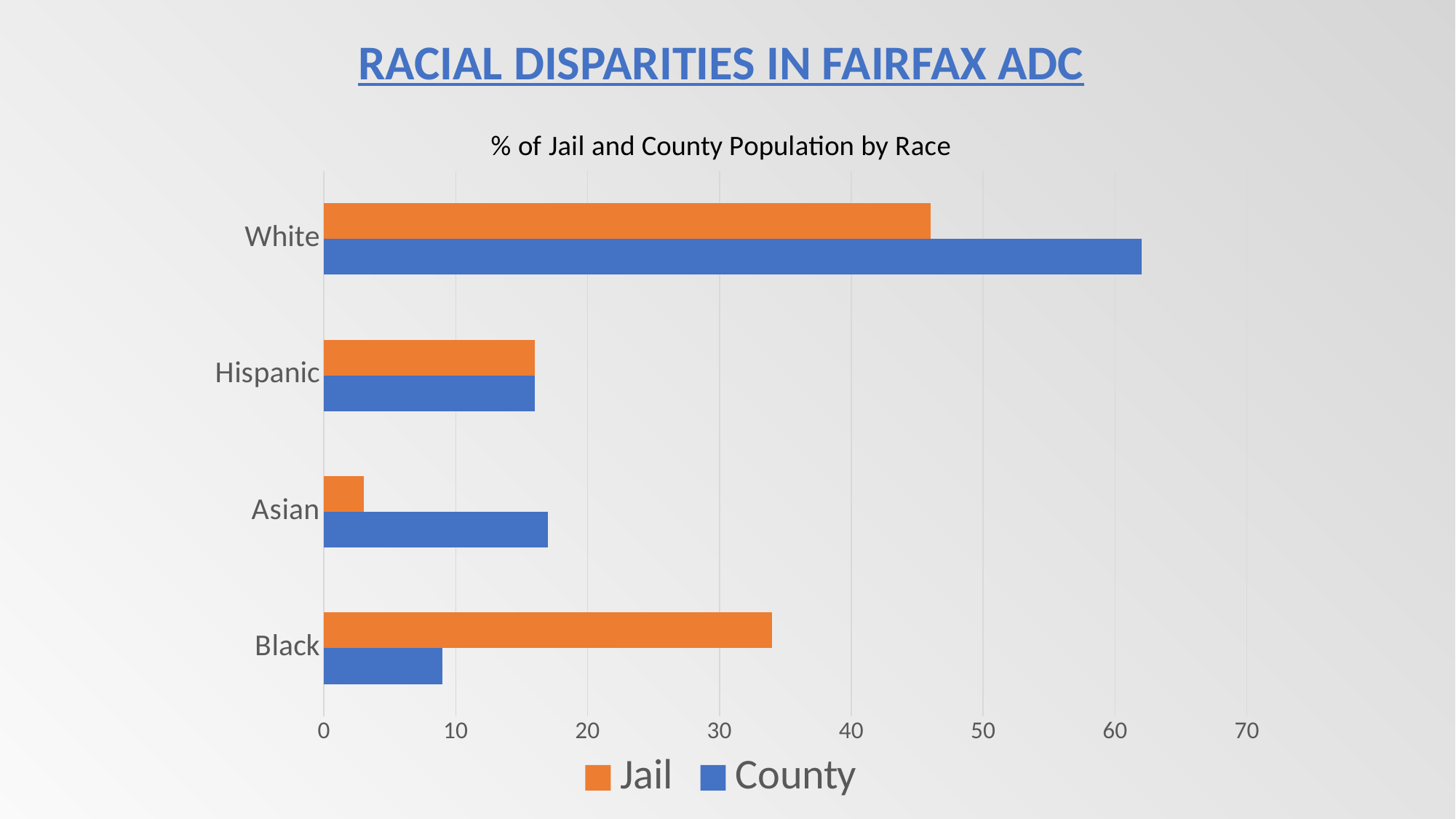
How many racial categories are plotted on the chart? 4 How many series does the legend list? 2 Which category has the lowest County value? Black Which category has the lowest Jail value? Asian Which category has the highest Jail value? White What kind of chart is shown on the slide? bar chart What is the subtitle of the chart? % of Jail and County Population by Race For Black, which is larger, the Jail value or the County value? Jail Is the Jail value for Black greater or less than 30? greater Is the County value for White greater or less than 60? greater Which category has the highest County value? White Is the Jail value for Asian greater or less than 10? less